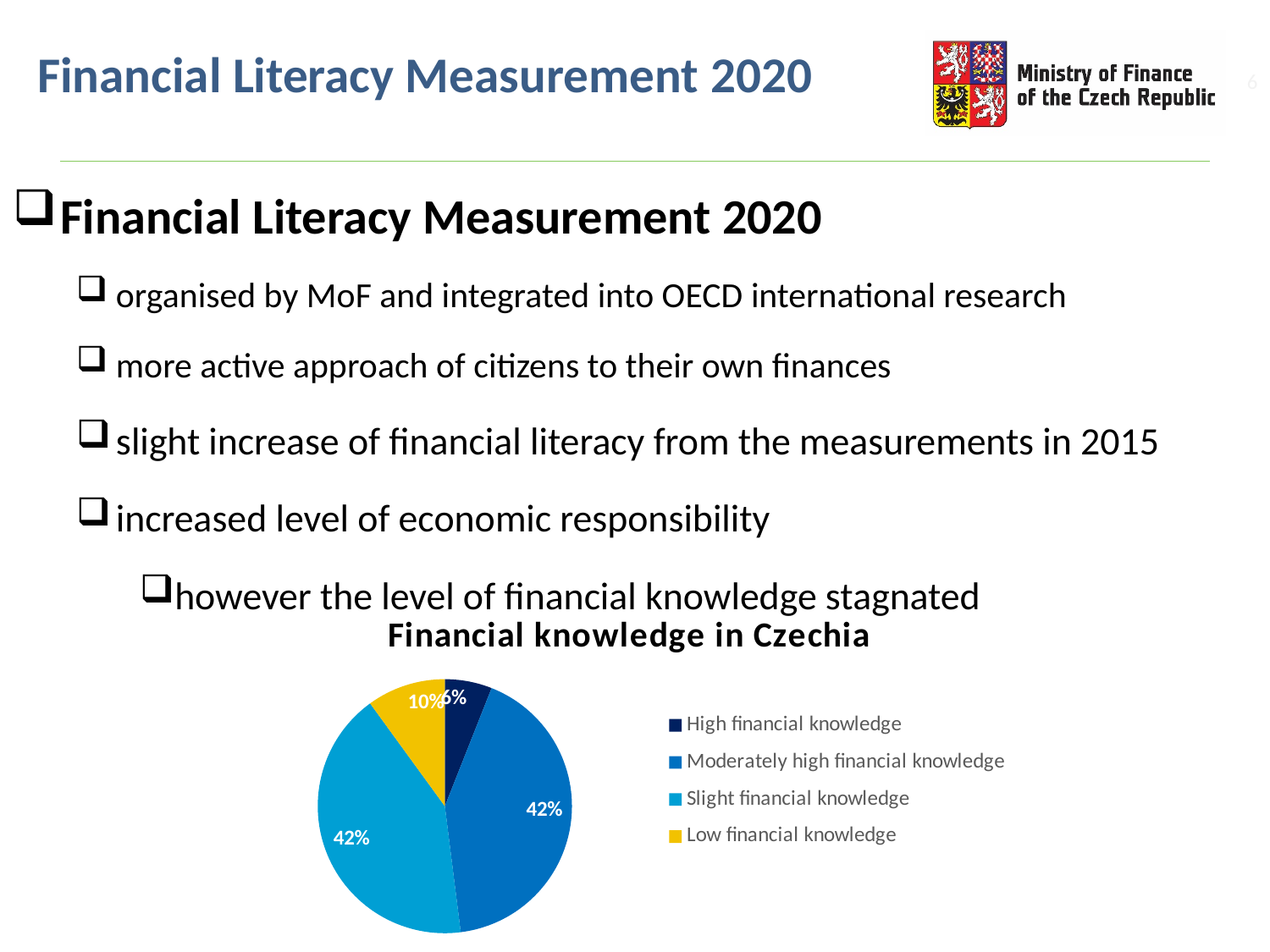
Which is larger, the share for Low financial knowledge or the share for High financial knowledge? Low financial knowledge What type of chart is shown on the slide? pie chart How many entries does the chart legend list? 4 What share of the pie is labelled Low financial knowledge? 10% Which category has the smallest share of the pie? High financial knowledge What is the difference between the share for Low financial knowledge and the share for High financial knowledge? 4% Which colour represents Low financial knowledge in the legend? yellow What share of the pie is labelled High financial knowledge? 6% How many slices does the pie chart have? 4 What is the value shown for Slight financial knowledge? 42% What is the title of the chart? Financial knowledge in Czechia What is the value shown for Moderately high financial knowledge? 42%